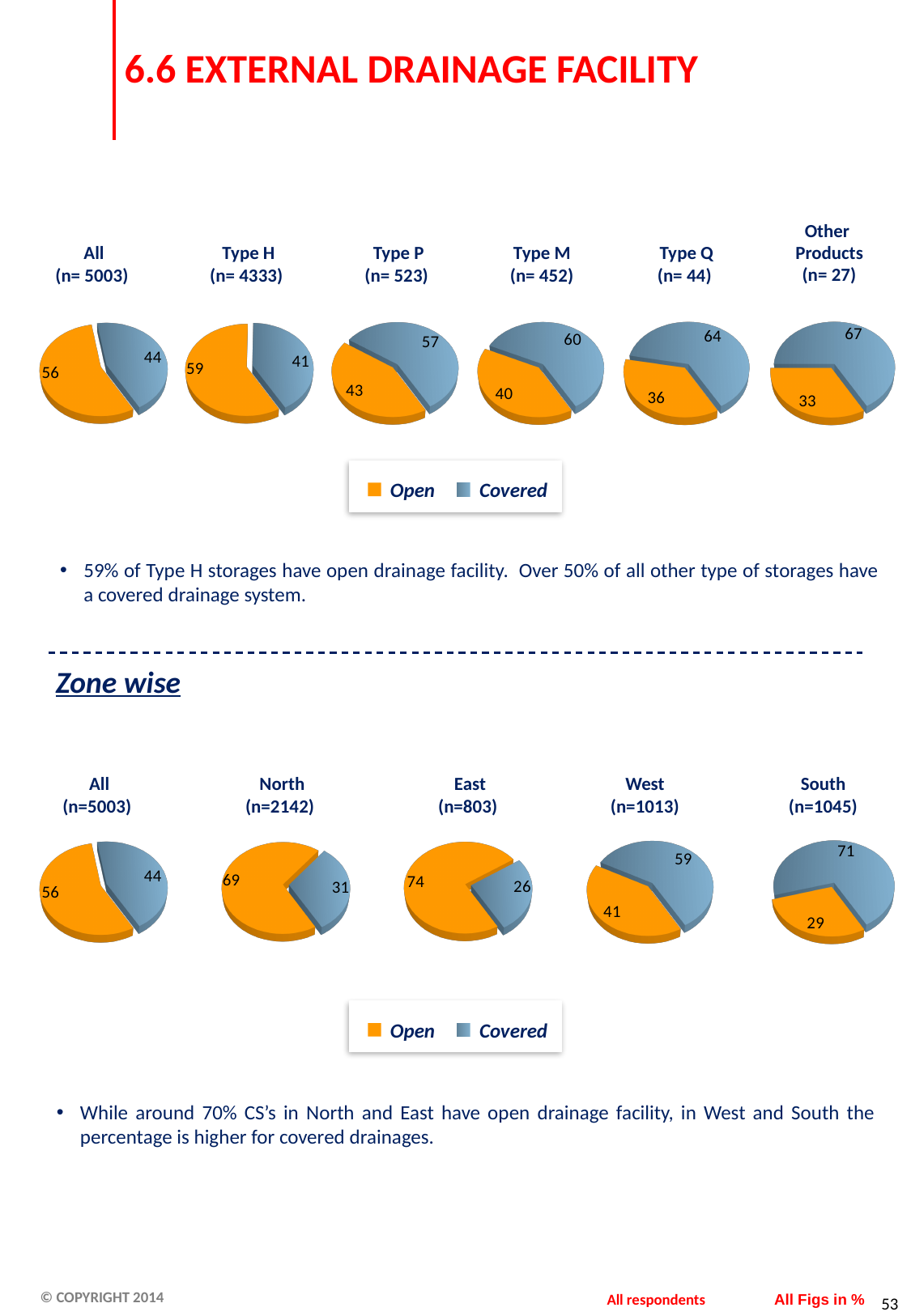
In the Zone wise pie charts, what is the Covered value for South (n=1045)? 71 In the top row of pie charts, what is the Open value for Type H (n= 4333)? 59 In the Zone wise pie charts, what colour represents Covered? Blue In the Zone wise pie charts, is the Open value for North larger or smaller than the Open value for West? larger What kind of chart is used for the All (n= 5003) chart in the top row? Pie chart In the top row of pie charts, what is the difference between the Open value for Type H and the Open value for Type M? 19 How many pie charts are in the Zone wise section? 5 In the Zone wise pie charts, what is the Open value for East (n=803)? 74 Among the Zone wise pie charts, which zone has the lowest Open value? South Among the top row of pie charts, which storage type has the highest Covered value? Other Products In the top row of pie charts, what is the Covered value for Type Q (n= 44)? 64 How many series does the legend below the top row of pie charts list? 2